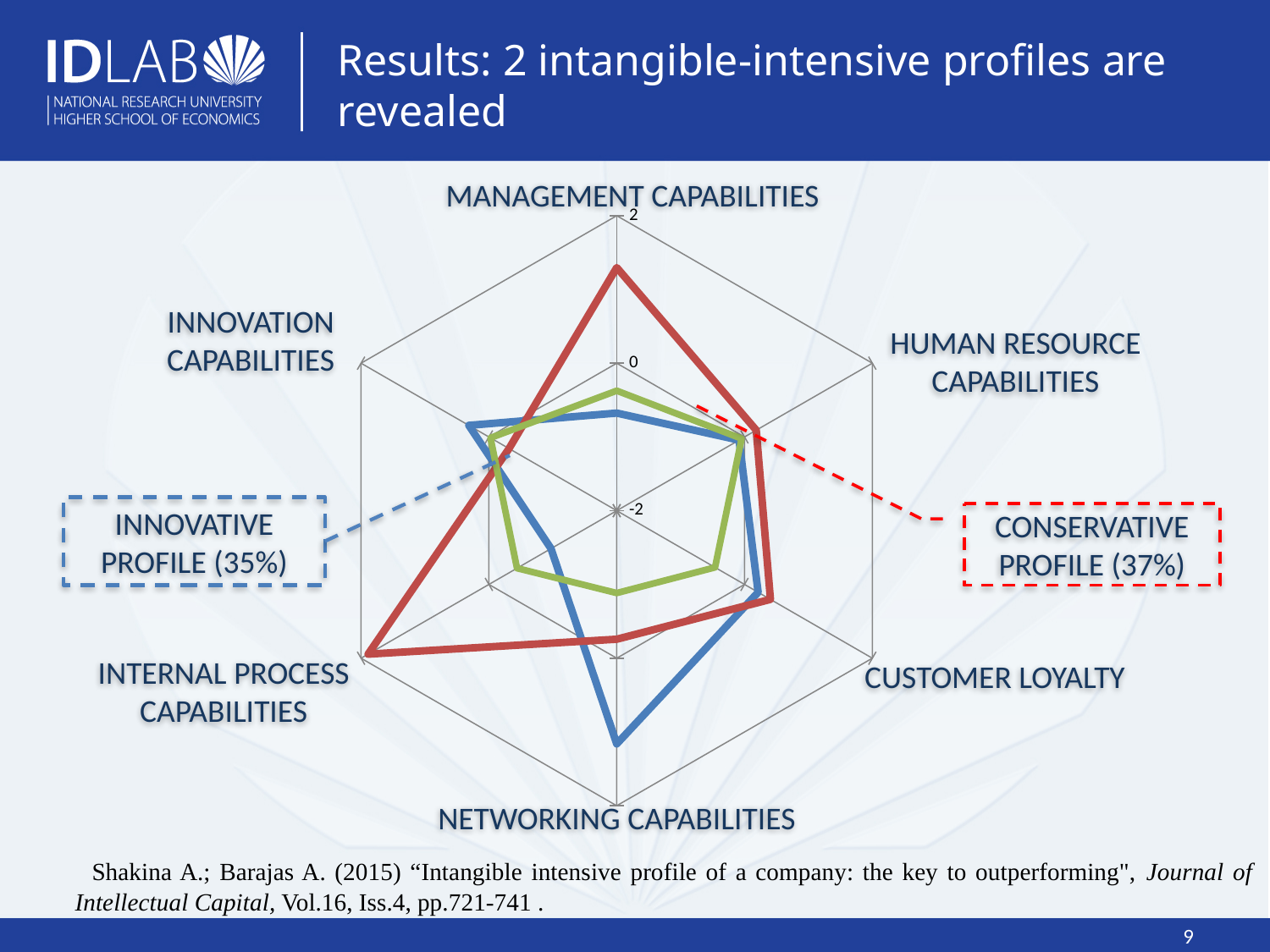
Is the green line's value for Management Capabilities greater or less than 0? less What kind of chart is shown on the slide? Radar chart On the Networking Capabilities axis, which line has the larger value, the blue line or the red line? Blue line On the Management Capabilities axis, which line has the larger value, the red line or the blue line? Red line Is the blue line's value for Internal Process Capabilities greater or less than 0? less Is the blue line's value for Networking Capabilities greater or less than 0? greater How many capability categories (axes) does the radar chart have? 6 How many data series (lines) are plotted on the radar chart? 3 Which profile does the blue line on the radar chart represent? Innovative profile (35%) For the blue line, which category has the highest value? Networking Capabilities Which profile does the red line on the radar chart represent? Conservative profile (37%)